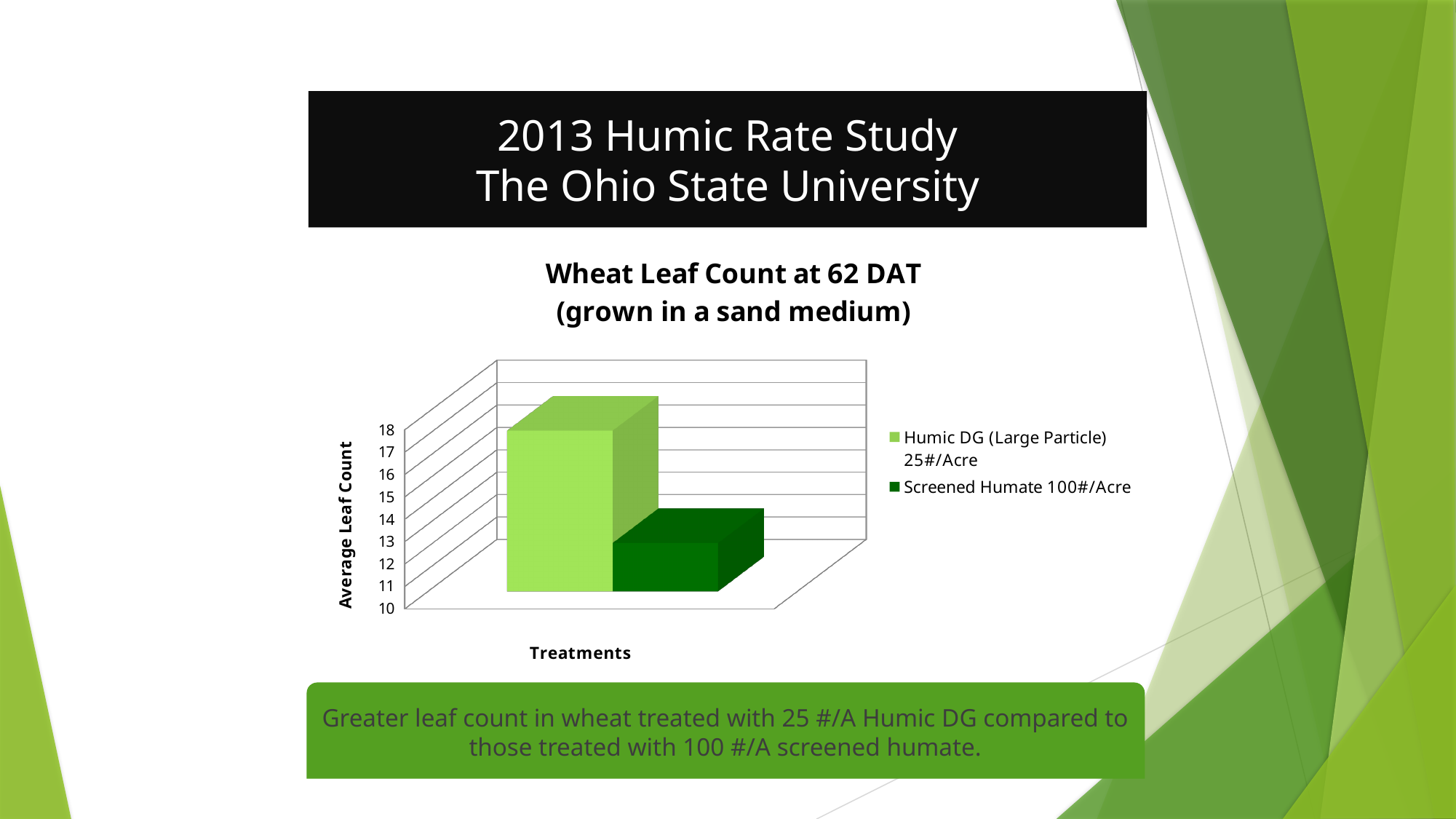
Which treatment has the lowest average leaf count? Screened Humate 100#/Acre Which is larger, the average leaf count for Humic DG (Large Particle) 25#/Acre or for Screened Humate 100#/Acre? Humic DG (Large Particle) 25#/Acre What kind of chart is shown on the slide? bar chart What is the label of the vertical axis of the chart? Average Leaf Count Is the average leaf count for Humic DG (Large Particle) 25#/Acre greater or less than 15? greater What is the title of the chart? Wheat Leaf Count at 62 DAT (grown in a sand medium) How many series does the chart legend list? 2 Is the average leaf count for Screened Humate 100#/Acre greater or less than 15? less How many bars are plotted in the chart? 2 Which treatment has the highest average leaf count? Humic DG (Large Particle) 25#/Acre